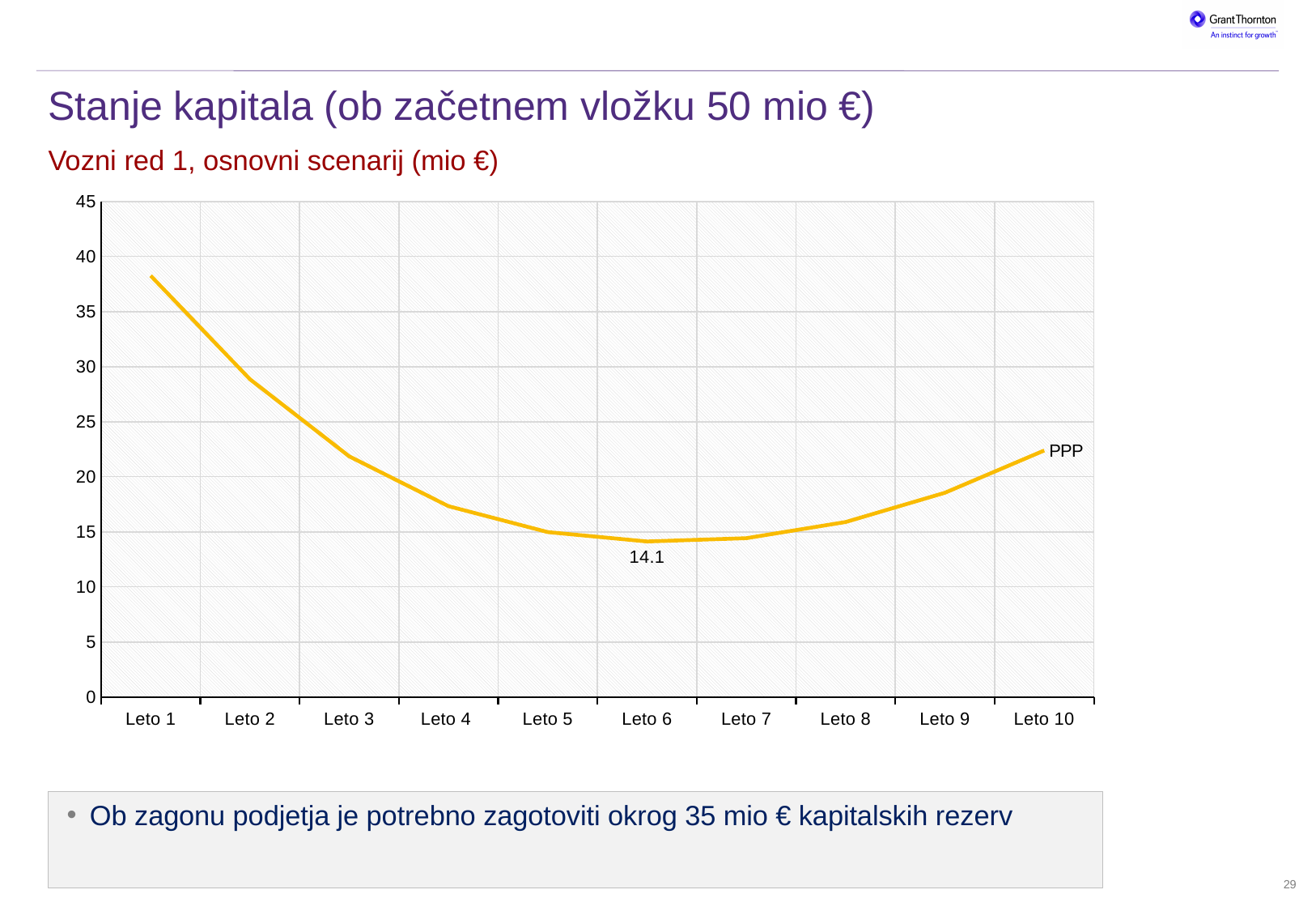
Which is larger, the value for Leto 1 or the value for Leto 10? Leto 1 How many years are shown on the x axis? 10 What is the value for Leto 6? 14.1 Is the value for Leto 10 greater or less than 20? greater Which is larger, the value for Leto 3 or the value for Leto 9? Leto 3 Is the value for Leto 1 greater or less than 35? greater Is the value for Leto 3 greater or less than 20? greater What kind of chart is shown on the slide? line chart What is the name of the series plotted on the chart? PPP Which year has the highest value? Leto 1 Do the values rise or fall from Leto 1 to Leto 6? fall